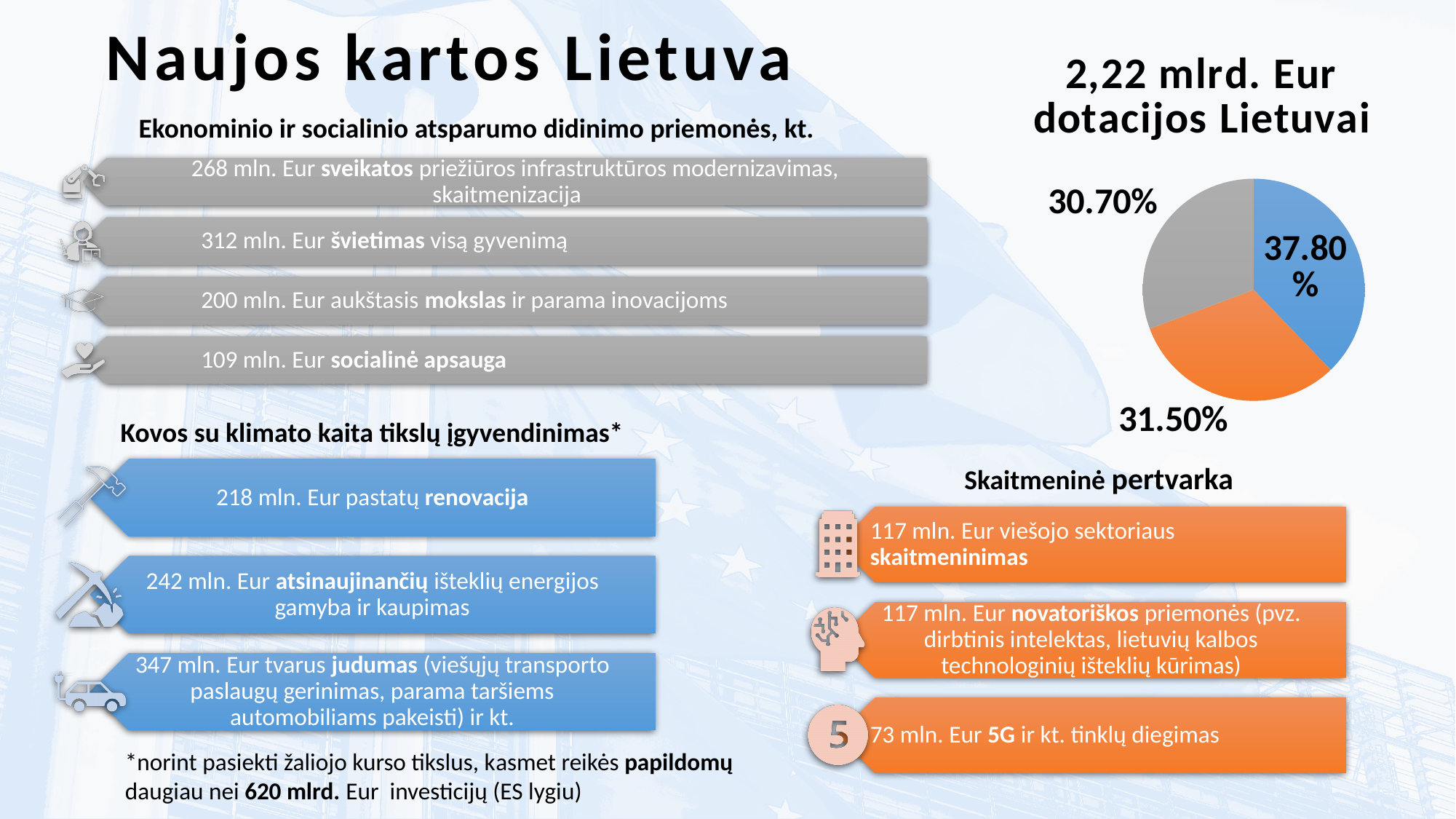
What is the difference between the largest and smallest slice percentages on the pie chart? 7.10% What is the largest percentage shown on the pie chart? 37.80% What percentage is labelled on the orange slice of the pie chart? 31.50% What is the difference between the blue slice (37.80%) and the orange slice (31.50%) on the pie chart? 6.30% What kind of chart is shown on the right side of the slide under "2,22 mlrd. Eur dotacijos Lietuvai"? pie chart What percentage is labelled on the grey slice of the pie chart? 30.70% Which slice of the pie chart is larger, the orange one or the grey one? orange What share of the pie does the blue slice represent? 37.80% What percentage is labelled on the blue slice of the pie chart? 37.80% What is the title shown above the pie chart? 2,22 mlrd. Eur dotacijos Lietuvai How many slices does the pie chart have? 3 What is the smallest percentage shown on the pie chart? 30.70%